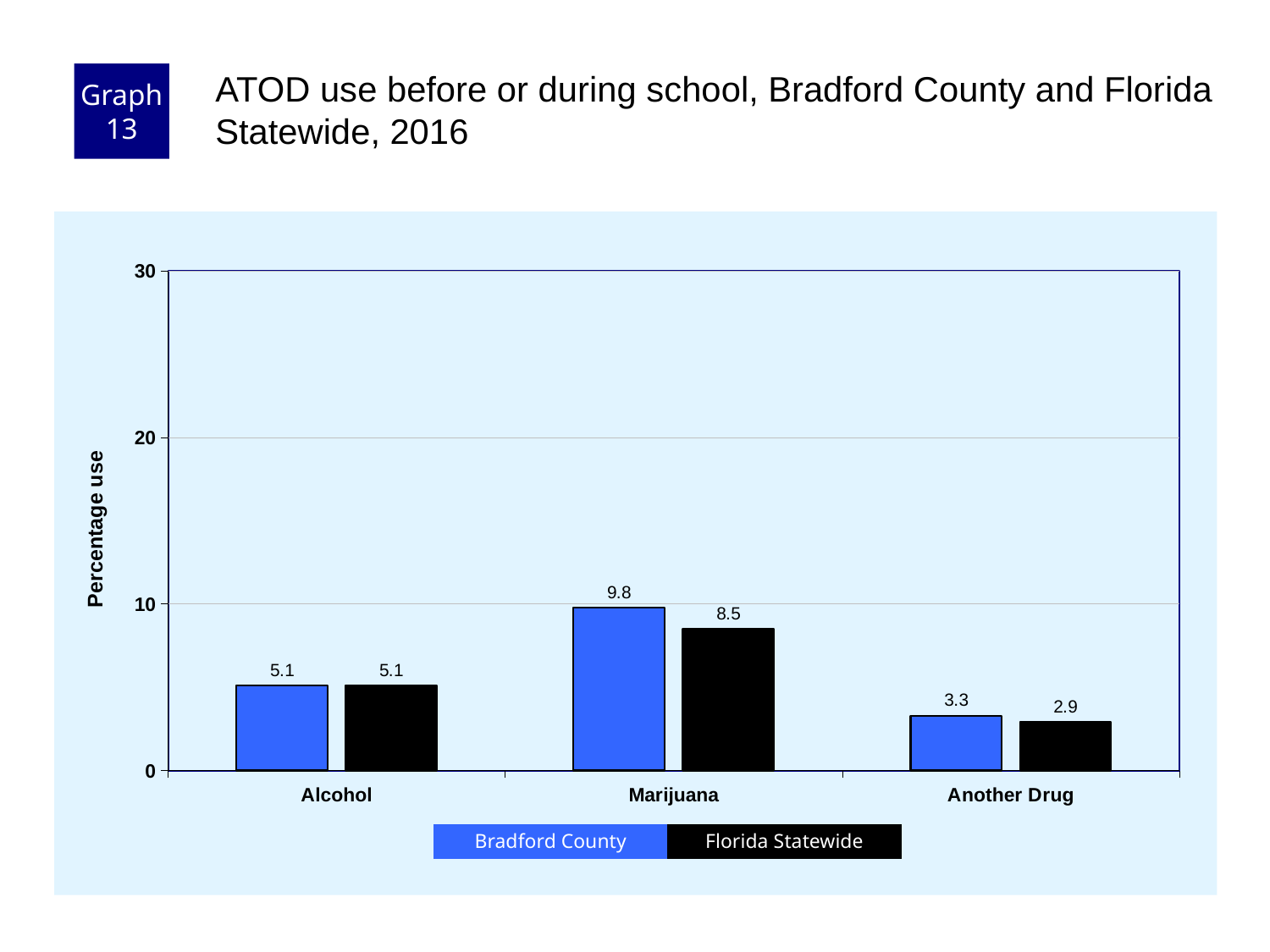
How many series does the legend list? 2 Which category has the highest Bradford County value? Marijuana What is the difference between the Bradford County values for Marijuana and Alcohol? 4.7 Which category has the lowest Florida Statewide value? Another Drug What kind of chart is shown on the slide? bar chart What is the difference between the Bradford County and Florida Statewide values for Marijuana? 1.3 Is the Bradford County value for Marijuana greater or less than 10? less What is the Bradford County value for Marijuana? 9.8 How many categories are shown on the x axis? 3 What is the Florida Statewide value for Another Drug? 2.9 What is the Florida Statewide value for Alcohol? 5.1 Which is larger for Another Drug, the Bradford County value or the Florida Statewide value? Bradford County